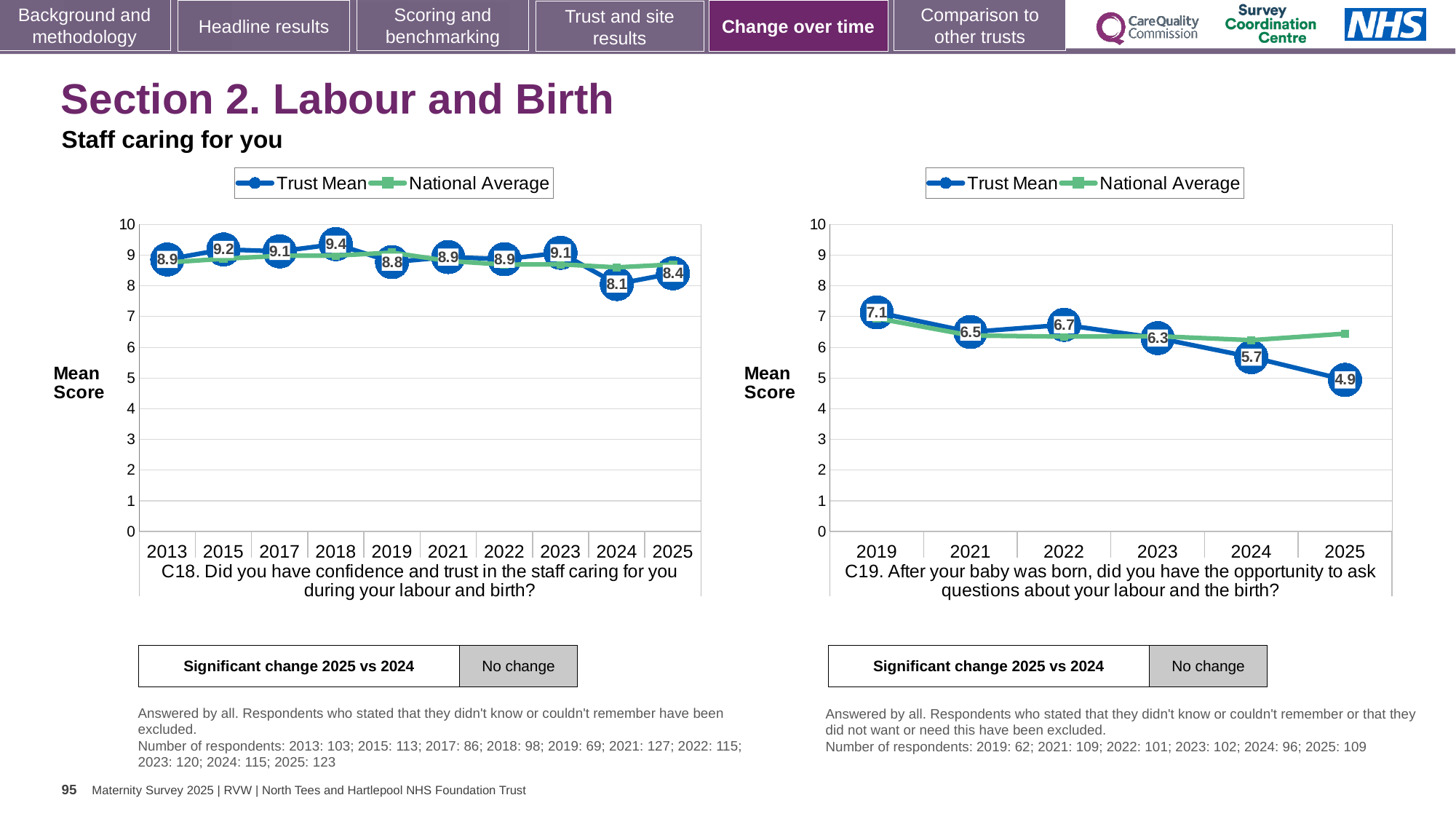
In the C18 chart (left), which year has the lowest Trust Mean? 2024 In the C18 chart (left), which year has the highest Trust Mean? 2018 In the C18 chart (left), how many years are shown on the x axis? 10 In the C19 chart (right), is the Trust Mean for 2022 or for 2023 larger? 2022 In the C19 chart (right), does the Trust Mean generally rise or fall from 2019 to 2025? fall In the C18 chart (left), what is the difference between the Trust Mean for 2018 and for 2024? 1.3 In the C19 chart (right), is the National Average for 2025 greater or less than 6? greater How many series does the legend of the C19 chart (right) list? 2 In the C19 chart (right), what is the Trust Mean for 2019? 7.1 In the C18 chart (left), what is the Trust Mean for 2025? 8.4 In the C19 chart (right), what is the Trust Mean for 2025? 4.9 In the C18 chart (left), what is the Trust Mean for 2018? 9.4